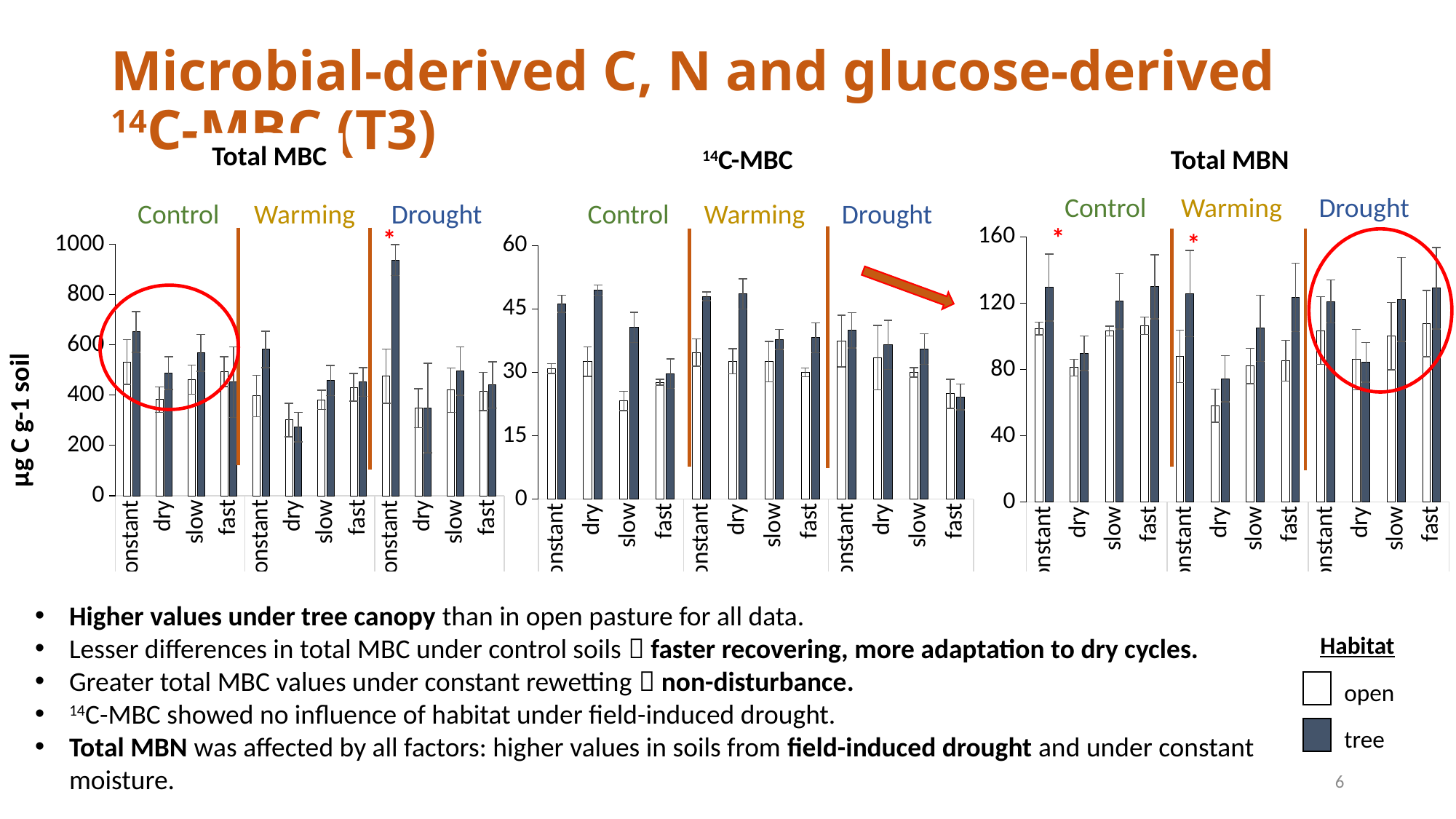
In the Total MBC chart, which bar is the highest? Drought constant, tree In the Total MBC chart, is the tree value for constant under Drought greater or less than 800? greater What kind of chart is the Total MBC chart? bar chart How many treatment groups (Control, Warming, Drought) are shown in the Total MBN chart? 3 In the 14C-MBC chart, is the tree value for dry under Control greater or less than 45? greater In the 14C-MBC chart, which is larger for slow under Control, the open bar or the tree bar? tree In the Total MBC chart, is the tree value for dry under Warming greater or less than 400? less What are the two habitat series shown in the legend? open and tree How many series does the Habitat legend list? 2 In the Total MBN chart, which bar is the lowest? Warming dry, open